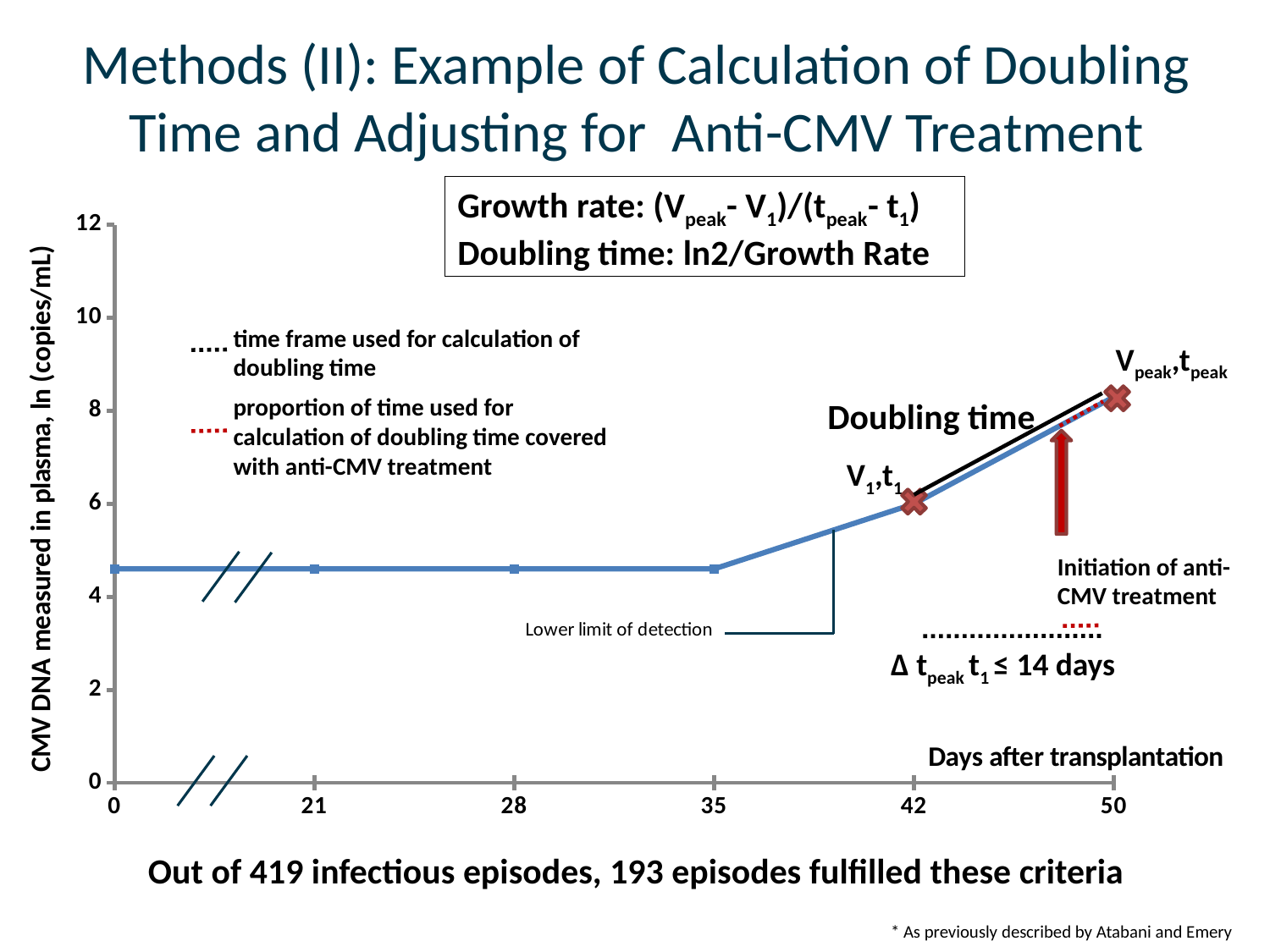
At which day on the x axis is the plotted CMV DNA value highest? 50 Is the plotted value at day 50 greater or less than 6? greater Which has the larger plotted value, day 28 or day 50? day 50 What kind of chart is shown on the slide? line chart Is the plotted value at day 42 greater or less than 4? greater What is the label of the y axis? CMV DNA measured in plasma, ln (copies/mL) Between day 35 and day 50, does the plotted CMV DNA value rise or fall? rise Is the plotted value at day 35 greater or less than 8? less How many labelled tick marks are on the x axis? 6 Between day 0 and day 35, does the plotted CMV DNA value rise, fall, or stay flat? stay flat What does the red arrow on the chart mark? Initiation of anti-CMV treatment